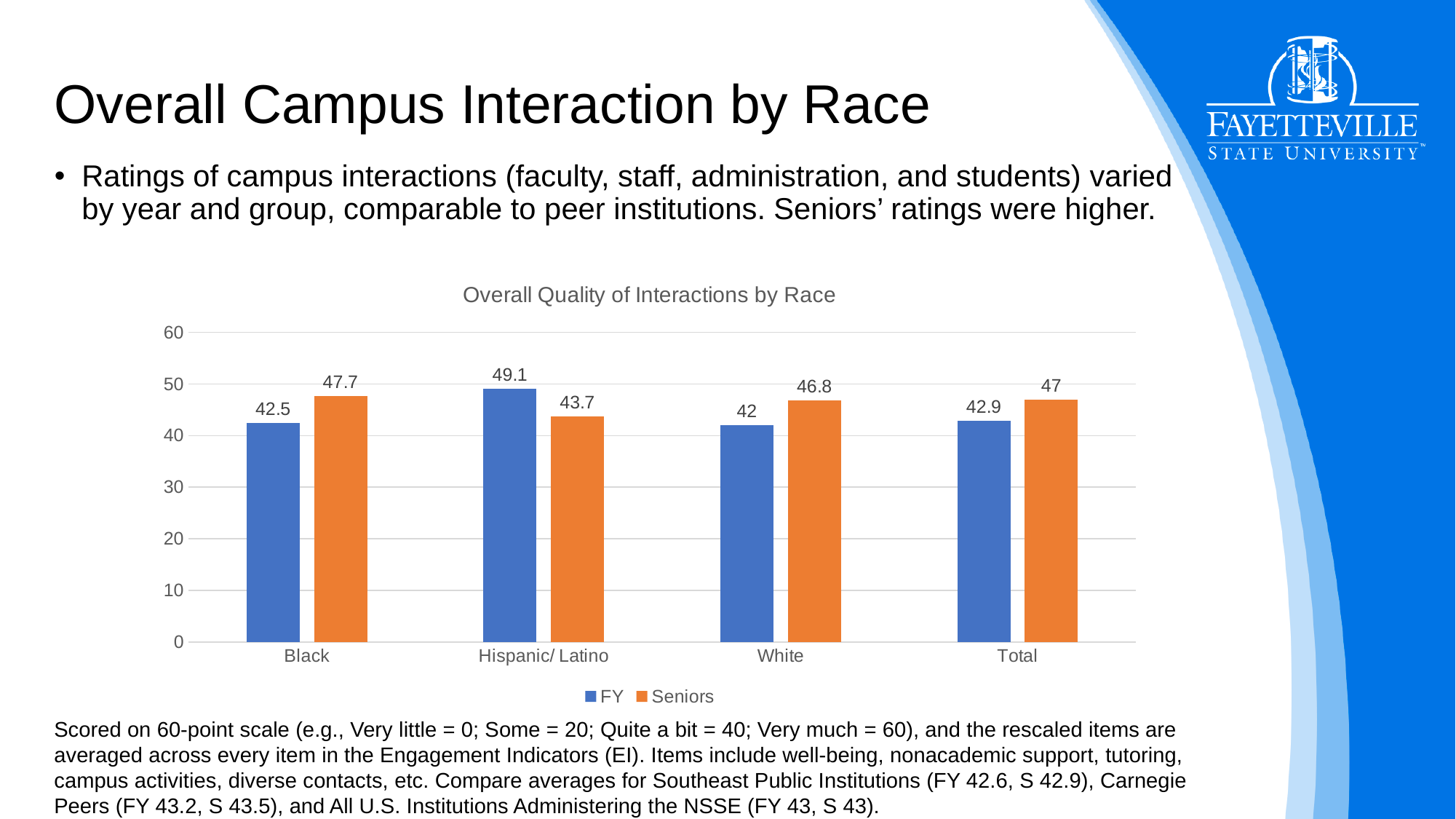
Which is larger for Hispanic/ Latino, the FY value or the Seniors value? FY What is the FY value for Total? 42.9 How many series does the legend list? 2 What is the difference between the Seniors and FY values for Black? 5.2 What is the FY value for Black? 42.5 Which category has the lowest Seniors value? Hispanic/ Latino What kind of chart is shown on the slide? Bar chart What is the title of the chart? Overall Quality of Interactions by Race Which category has the highest FY value? Hispanic/ Latino What is the Seniors value for White? 46.8 What is the Seniors value for Hispanic/ Latino? 43.7 How many categories are shown on the x axis? 4